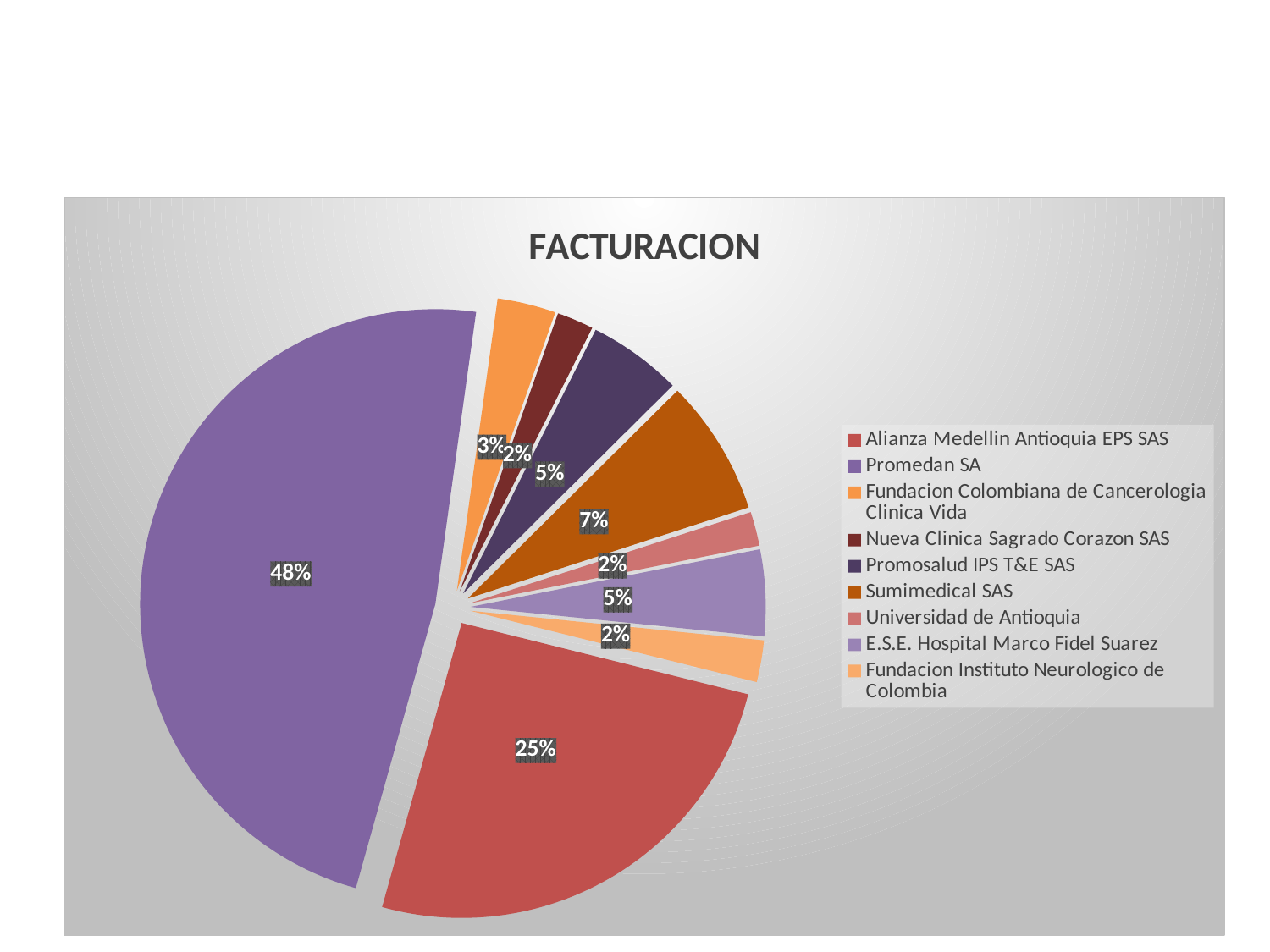
What share of the pie does Promedan SA have? 48% Which category has the largest share of the pie? Promedan SA What type of chart is shown on the slide? pie chart What is the difference in percentage points between Promedan SA and Alianza Medellin Antioquia EPS SAS? 23 What is the title of the chart? FACTURACION Which is larger, the share for Sumimedical SAS or the share for E.S.E. Hospital Marco Fidel Suarez? Sumimedical SAS How many entries does the legend list? 9 What share of the pie does Alianza Medellin Antioquia EPS SAS have? 25% How many slices does the pie chart have? 9 What share of the pie does Promosalud IPS T&E SAS have? 5%